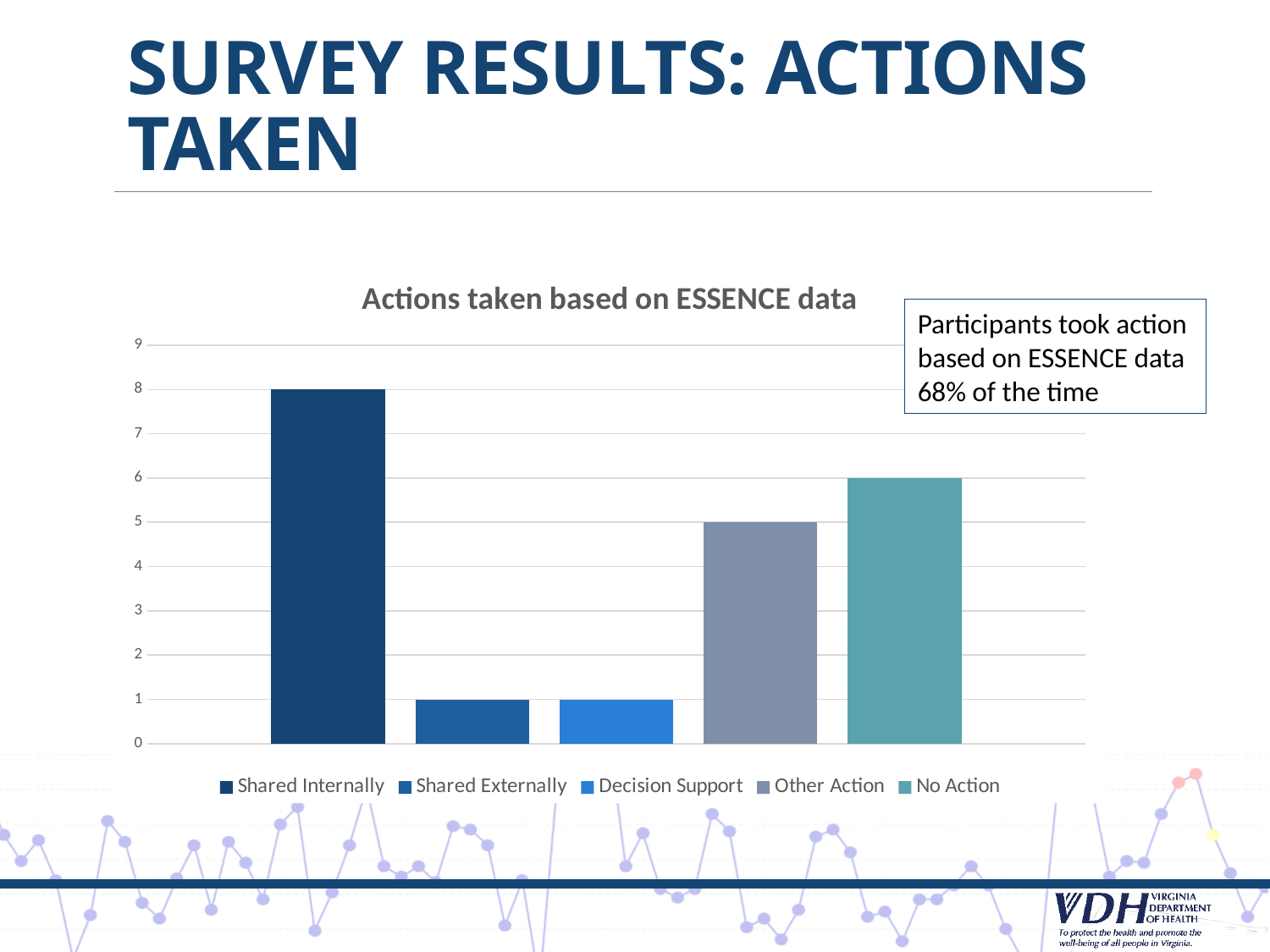
What is the value for Other Action in the chart? 5 How many entries does the chart legend list? 5 What is the value for Shared Externally in the chart? 1 What is the value for No Action in the chart? 6 What is the value for Shared Internally in the chart? 8 What is the difference between the values for No Action and Other Action? 1 Is the value for Shared Internally greater or less than 7? greater What type of chart is shown on the slide? bar chart Which category has the highest value in the chart? Shared Internally What is the difference between the values for Shared Internally and No Action? 2 Which is larger, the value for Other Action or the value for Decision Support? Other Action How many bars are plotted in the chart? 5